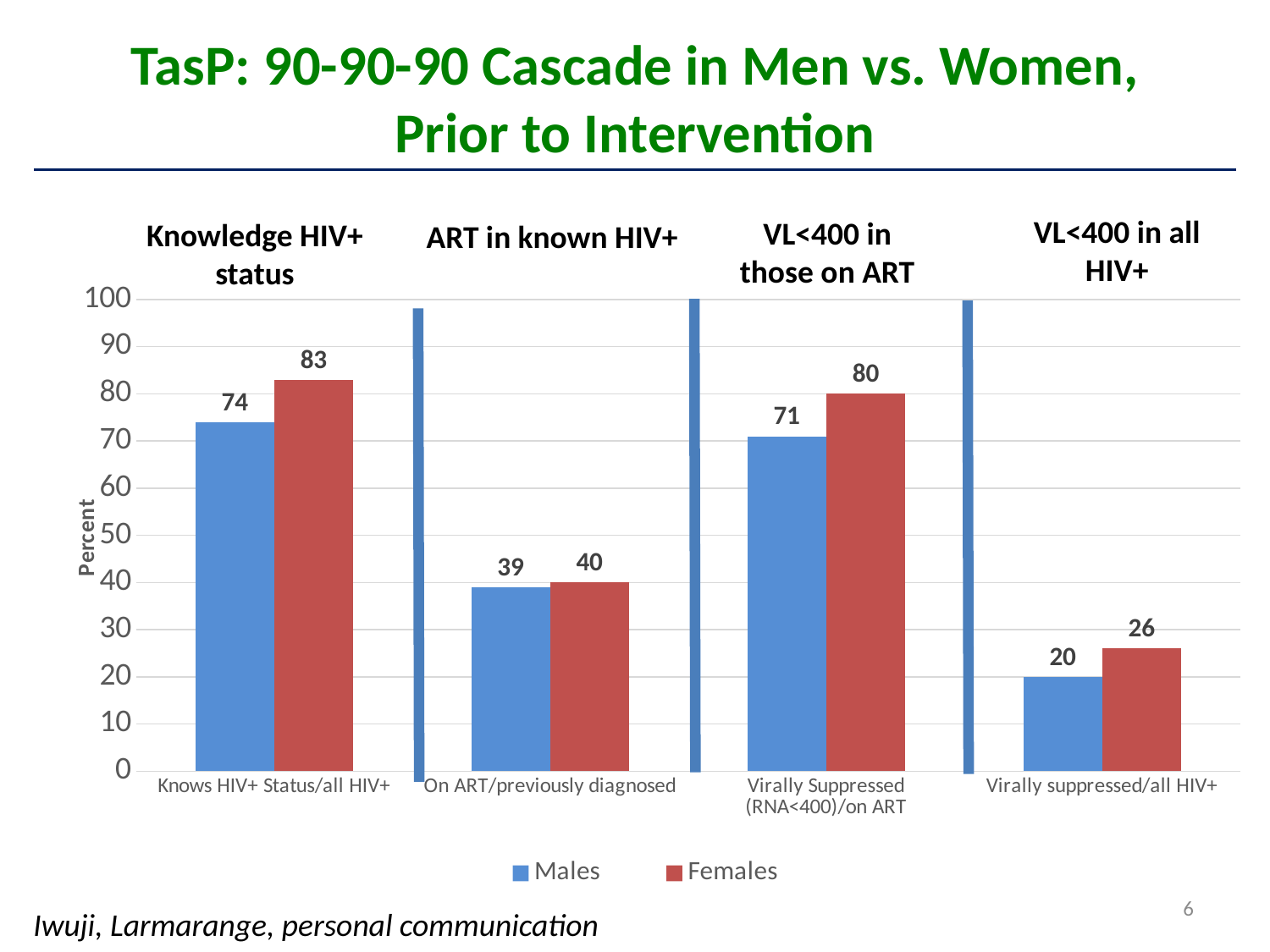
What is the value for Males in the 'Knows HIV+ Status/all HIV+' category? 74 What is the difference between the Females and Males values in the 'Knows HIV+ Status/all HIV+' category? 9 How many categories are shown on the x axis? 4 What is the value for Females in the 'Virally Suppressed (RNA<400)/on ART' category? 80 Is the Males value for 'On ART/previously diagnosed' greater or less than 50? less In which category is the Males value lowest? Virally suppressed/all HIV+ In which category is the Females value highest? Knows HIV+ Status/all HIV+ Which is larger in the 'Virally Suppressed (RNA<400)/on ART' category, Males or Females? Females What is the value for Females in the 'Virally suppressed/all HIV+' category? 26 What kind of chart is shown on the slide? bar chart How many series does the legend list? 2 What is the label of the y axis? Percent